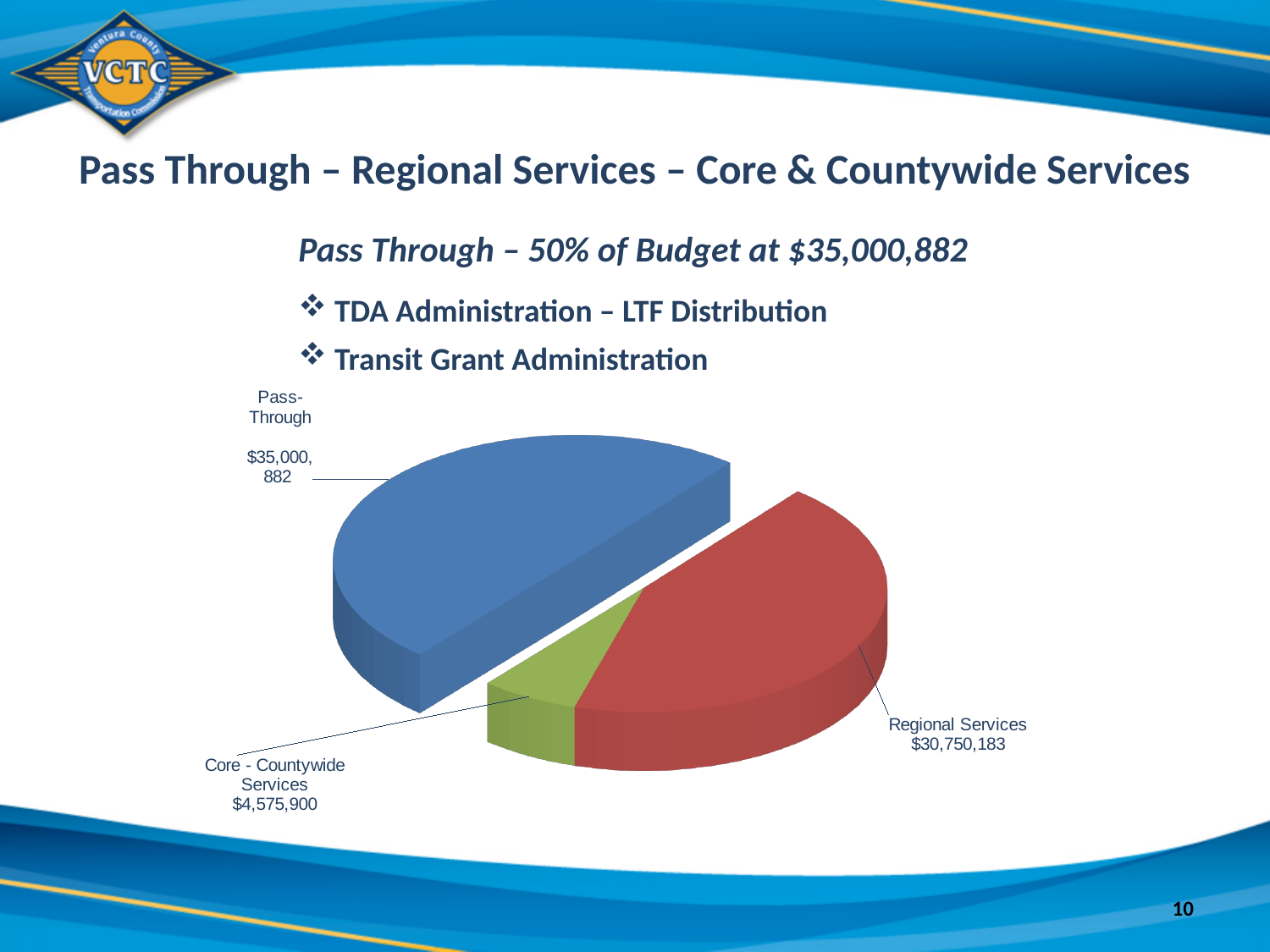
Which category has the largest slice of the pie? Pass-Through How many slices does the pie chart have? 3 What type of chart is shown on the slide? Pie chart What is the value of the Core - Countywide Services slice? $4,575,900 What is the value of the Pass-Through slice? $35,000,882 According to the slide, what share of the budget does Pass-Through represent? 50% What is the difference between the Regional Services value and the Core - Countywide Services value? $26,174,283 What is the value of the Regional Services slice? $30,750,183 What is the difference between the Pass-Through value and the Regional Services value? $4,250,699 Which is larger, Regional Services or Core - Countywide Services? Regional Services Which category has the smallest slice of the pie? Core - Countywide Services What colour is the Regional Services slice? Red